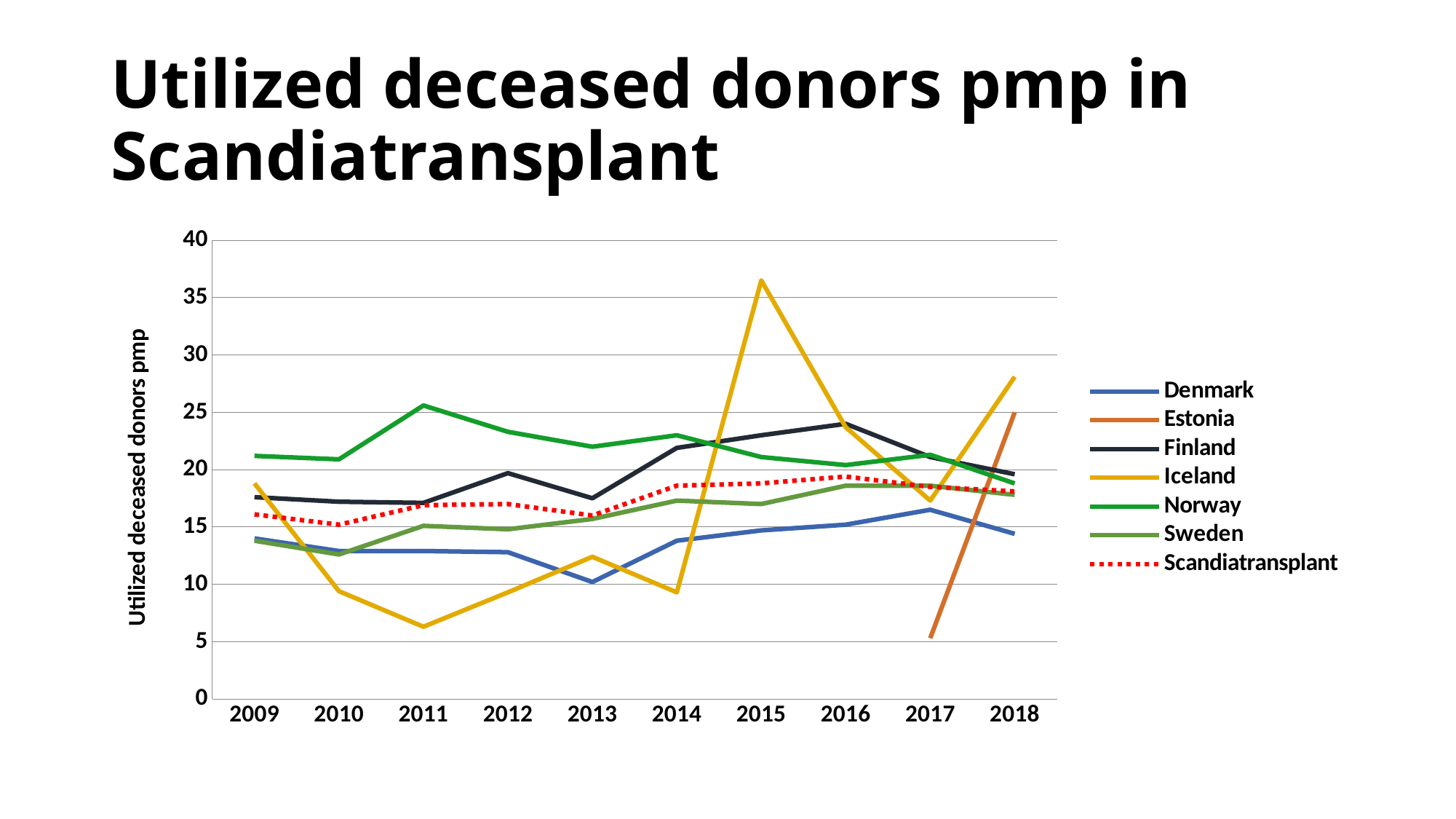
How many series does the legend list? 7 Is the value for Iceland in 2015 greater or less than 35? greater What kind of chart is shown on the slide? line chart In 2011, which is larger, the value for Norway or the value for Finland? Norway Which series has the lowest value in 2010? Iceland Which series has the highest value in 2015? Iceland Is the value for Finland in 2016 greater or less than 20? greater Which series is drawn as a dotted line? Scandiatransplant Does the value for Estonia rise or fall from 2017 to 2018? rise How many years are shown on the x axis? 10 Which series has the lowest value in 2013? Denmark Is the value for Iceland in 2011 greater or less than 10? less